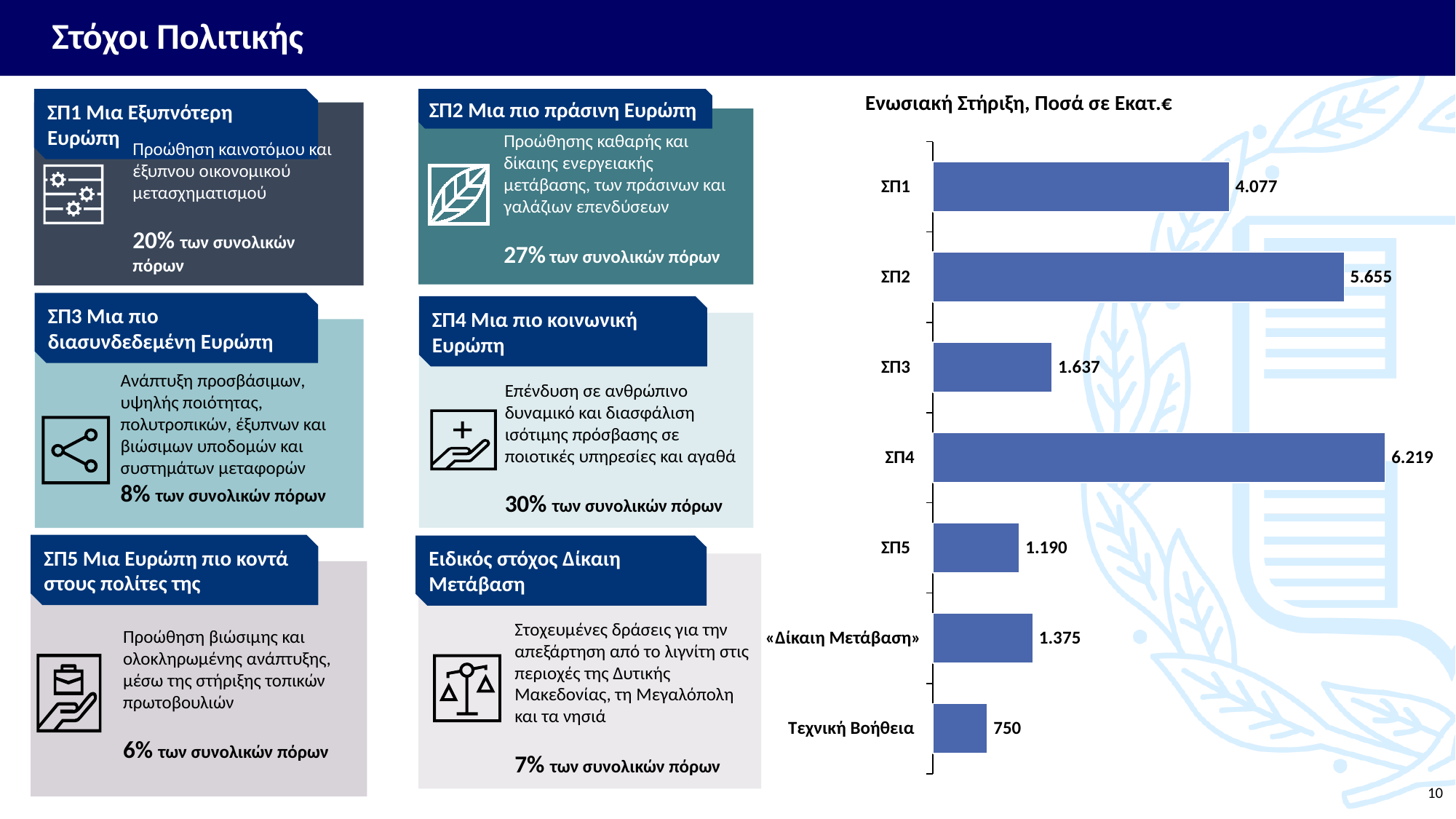
Which category has the lowest value in the chart? Τεχνική Βοήθεια Which has a larger value, ΣΠ5 or «Δίκαιη Μετάβαση»? «Δίκαιη Μετάβαση» What kind of chart is shown on the slide? Bar chart What is the difference between the values for ΣΠ4 and ΣΠ2? 564 What is the title of the chart? Ενωσιακή Στήριξη, Ποσά σε Εκατ.€ What is the value for ΣΠ2 in the chart? 5.655 Which category has the highest value in the chart? ΣΠ4 What is the value for «Δίκαιη Μετάβαση» in the chart? 1.375 How many categories are shown in the chart? 7 What is the value for ΣΠ1 in the chart? 4.077 What is the value for Τεχνική Βοήθεια in the chart? 750 What is the difference between the values for ΣΠ1 and ΣΠ3? 2.440